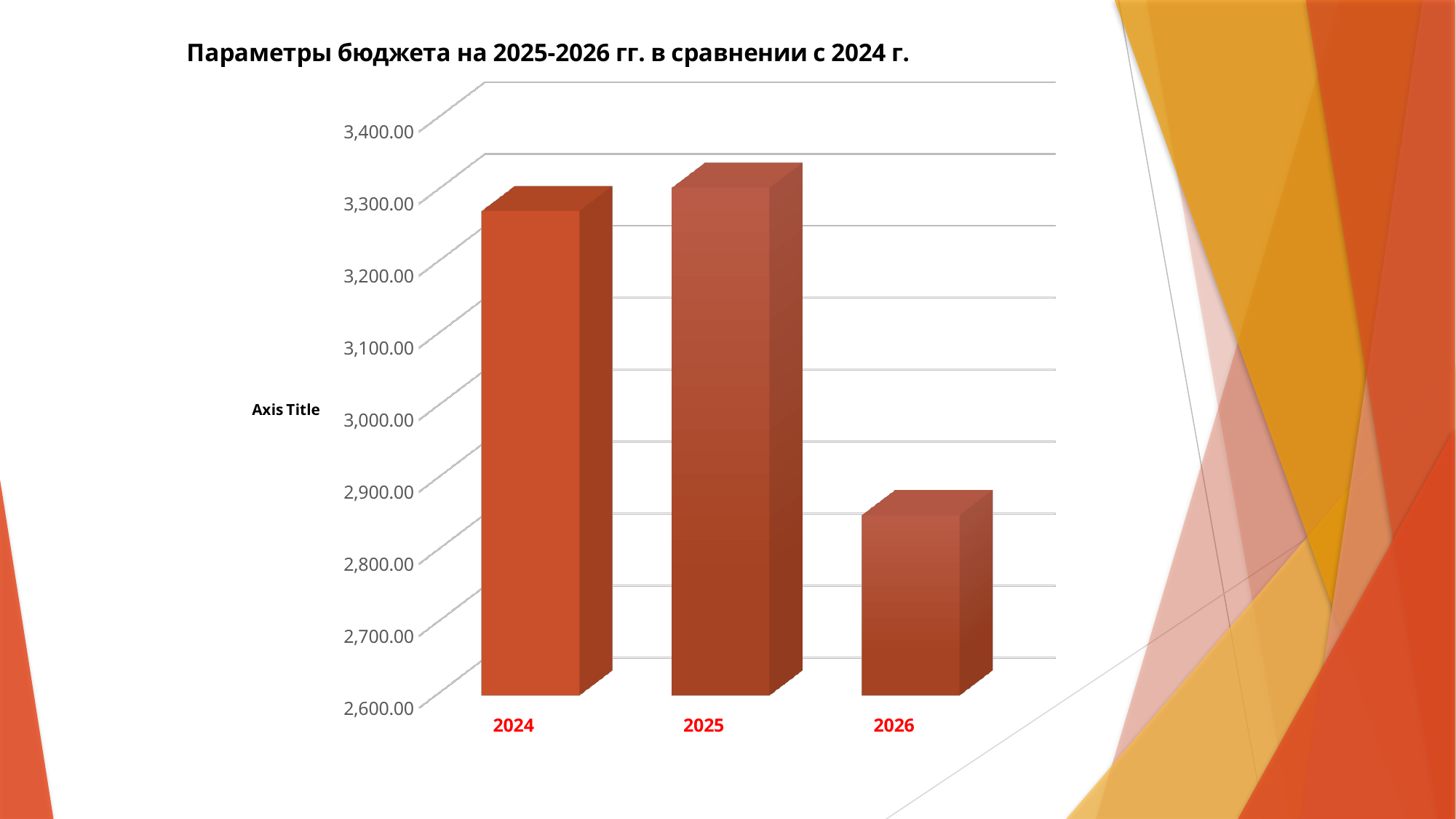
Is the value for 2026 greater or less than 2,900.00? less Does the value rise or fall from 2025 to 2026? fall Which year has the lowest value on the chart? 2026 What is the title of the chart? Параметры бюджета на 2025-2026 гг. в сравнении с 2024 г. Is the value for 2024 greater or less than 3,200.00? greater Which year has the highest value on the chart? 2025 What is the lowest value shown on the vertical axis? 2,600.00 What kind of chart is shown on the slide? bar chart Which is larger, the value for 2024 or the value for 2026? 2024 Is the value for 2026 greater or less than 2,800.00? greater How many categories (years) are plotted on the chart? 3